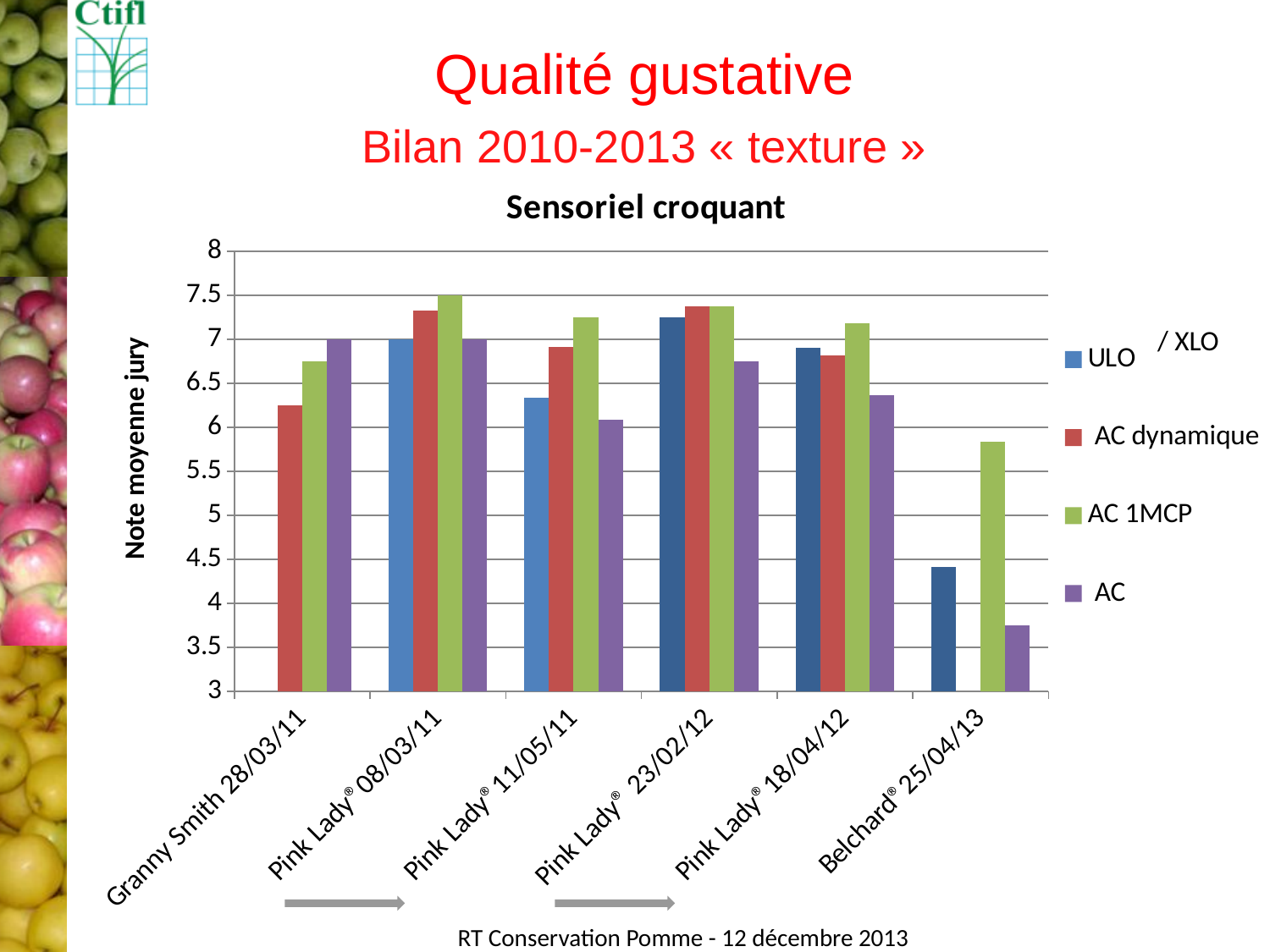
Which category has the lowest AC value? Belchard® 25/04/13 For Granny Smith 28/03/11, which is larger: AC dynamique or AC? AC Which category has the lowest AC 1MCP value? Belchard® 25/04/13 How many series does the legend list? 4 What type of chart is shown on the slide? bar chart Is the ULO value for Belchard® 25/04/13 greater or less than 5? less How many categories are shown on the x axis? 6 What is the title of the chart? Sensoriel croquant Is the AC value for Pink Lady® 18/04/12 greater or less than 6.5? less What is the label of the vertical axis? Note moyenne jury Is the AC 1MCP value for Belchard® 25/04/13 greater or less than 5.5? greater For Pink Lady® 11/05/11, which is larger: AC 1MCP or AC? AC 1MCP